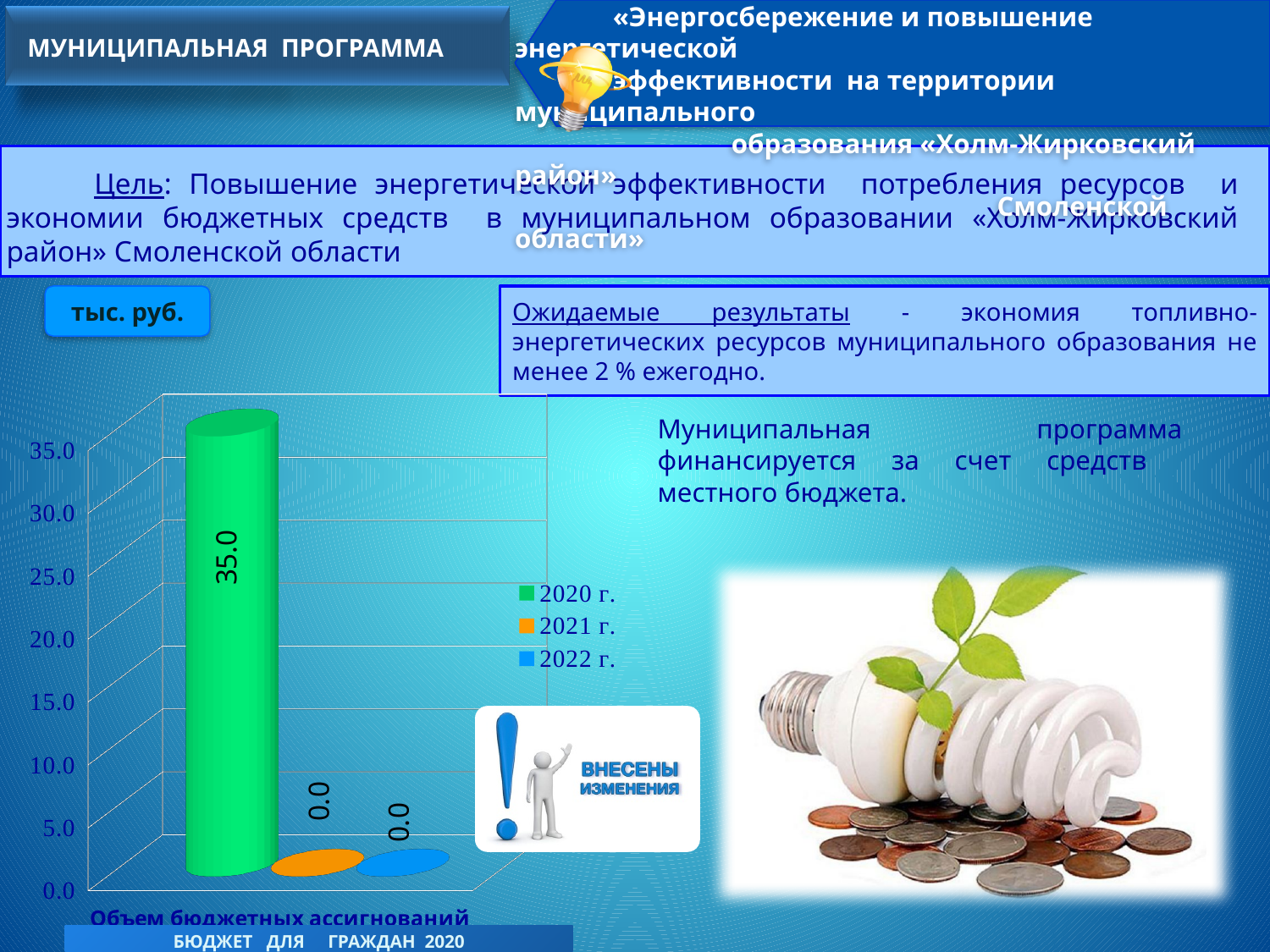
What is the total of the values for 2020 г., 2021 г. and 2022 г.? 35.0 What unit is indicated for the chart values? тыс. руб. Is the value for 2020 г. greater or less than 30.0? greater What colour is the bar for 2020 г. in the chart? green What kind of chart is shown on the slide? bar chart What is the value for 2021 г. in the chart? 0.0 What is the value for 2022 г. in the chart? 0.0 What is the difference between the values for 2020 г. and 2021 г.? 35.0 Which is larger, the value for 2020 г. or the value for 2022 г.? 2020 г. What is the value for 2020 г. in the chart? 35.0 How many series does the chart legend list? 3 Which year has the highest value in the chart? 2020 г.